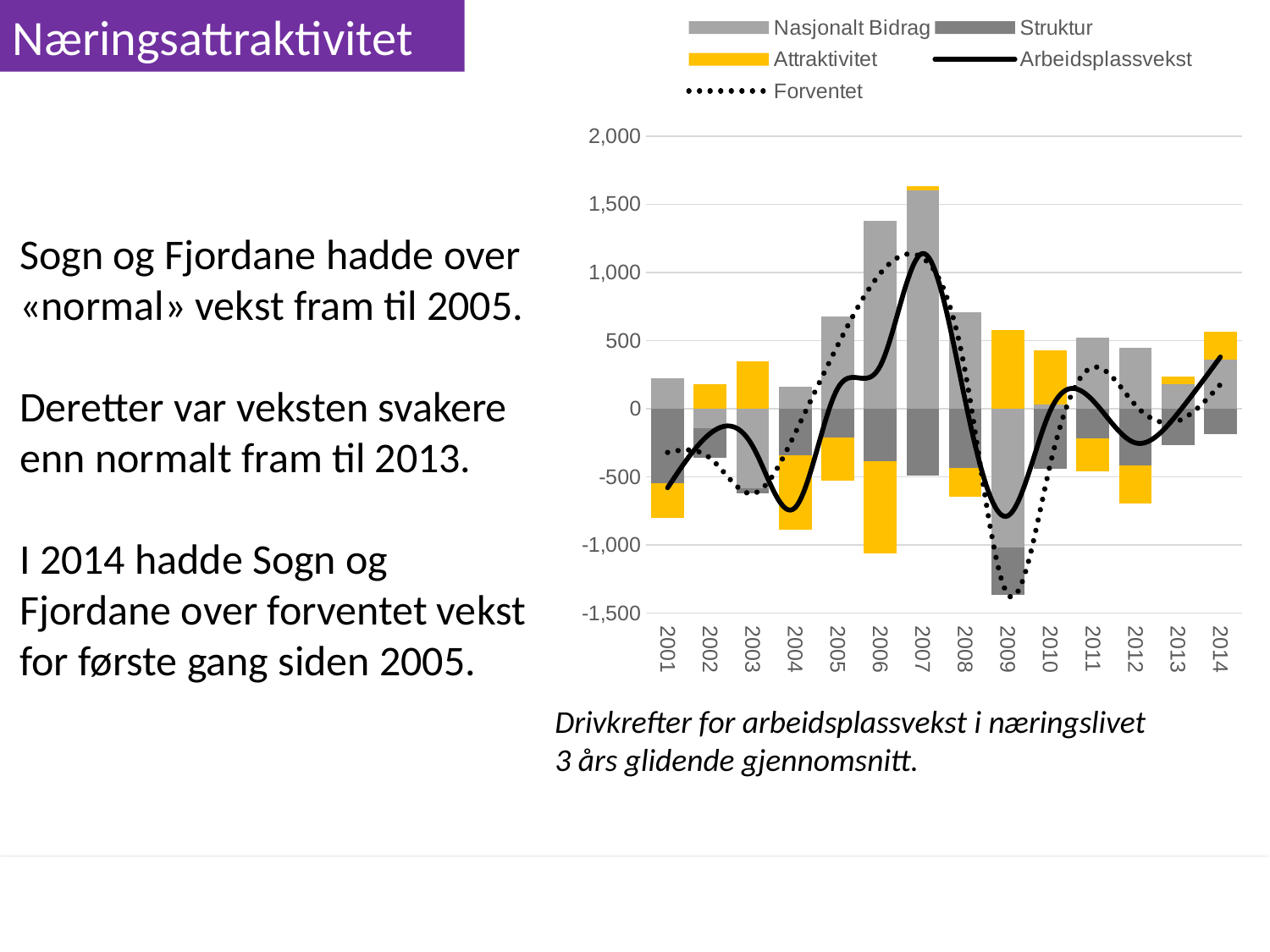
How many series does the legend list? 5 Does the Nasjonalt Bidrag bar rise or fall from 2004 to 2007? rise Is the Nasjonalt Bidrag value for 2007 greater or less than 1,500? greater In which year does the Arbeidsplassvekst line reach its lowest point? 2009 How many years are shown on the x axis? 14 What kind of chart is this? Stacked bar chart with line series Is the Nasjonalt Bidrag value for 2006 greater or less than 1,000? greater Is the Arbeidsplassvekst value for 2009 greater or less than -500? less In which year is the Nasjonalt Bidrag bar lowest (most negative)? 2009 In which year does the Arbeidsplassvekst line reach its highest point? 2007 Which colour represents Attraktivitet in the legend? Yellow In which year is the Nasjonalt Bidrag bar highest? 2007